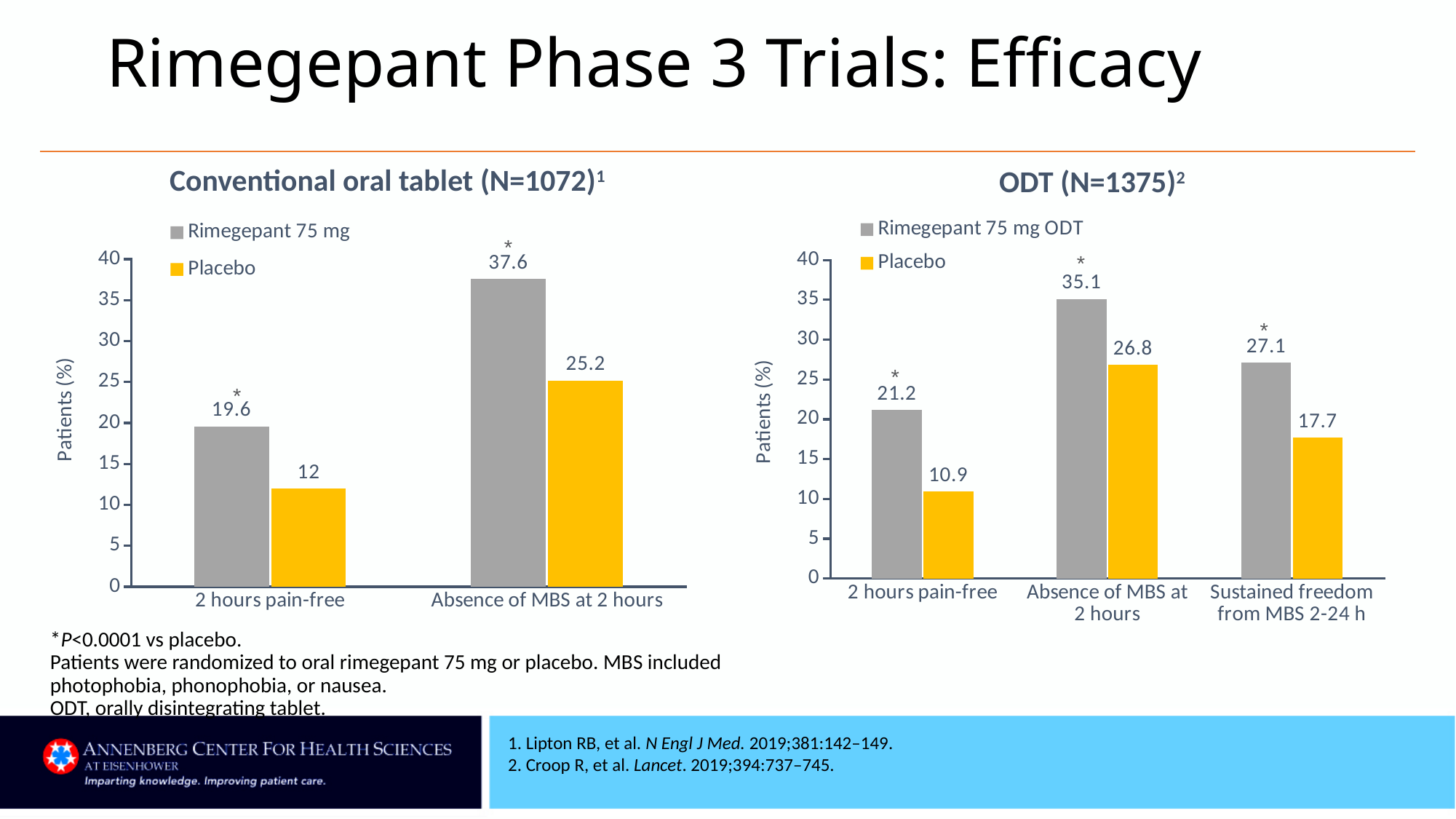
In the Conventional oral tablet (N=1072) chart, what is the value for Rimegepant 75 mg for 2 hours pain-free? 19.6 What type of chart is the ODT (N=1375) chart? Bar chart In the ODT (N=1375) chart, what is the value for Rimegepant 75 mg ODT for Sustained freedom from MBS 2-24 h? 27.1 In the ODT (N=1375) chart, what is the value for Placebo for 2 hours pain-free? 10.9 In the Conventional oral tablet (N=1072) chart, what is the difference between Rimegepant 75 mg and Placebo for 2 hours pain-free? 7.6 In the ODT (N=1375) chart, which category has the highest Rimegepant 75 mg ODT value? Absence of MBS at 2 hours In the ODT (N=1375) chart, which category has the lowest Placebo value? 2 hours pain-free How many series does the legend of the Conventional oral tablet (N=1072) chart list? 2 In the Conventional oral tablet (N=1072) chart, which is larger: Placebo for Absence of MBS at 2 hours or Rimegepant 75 mg for 2 hours pain-free? Placebo for Absence of MBS at 2 hours In the Conventional oral tablet (N=1072) chart, what is the value for Placebo for Absence of MBS at 2 hours? 25.2 In the ODT (N=1375) chart, what is the difference between Rimegepant 75 mg ODT and Placebo for Absence of MBS at 2 hours? 8.3 How many categories are shown on the x axis of the ODT (N=1375) chart? 3